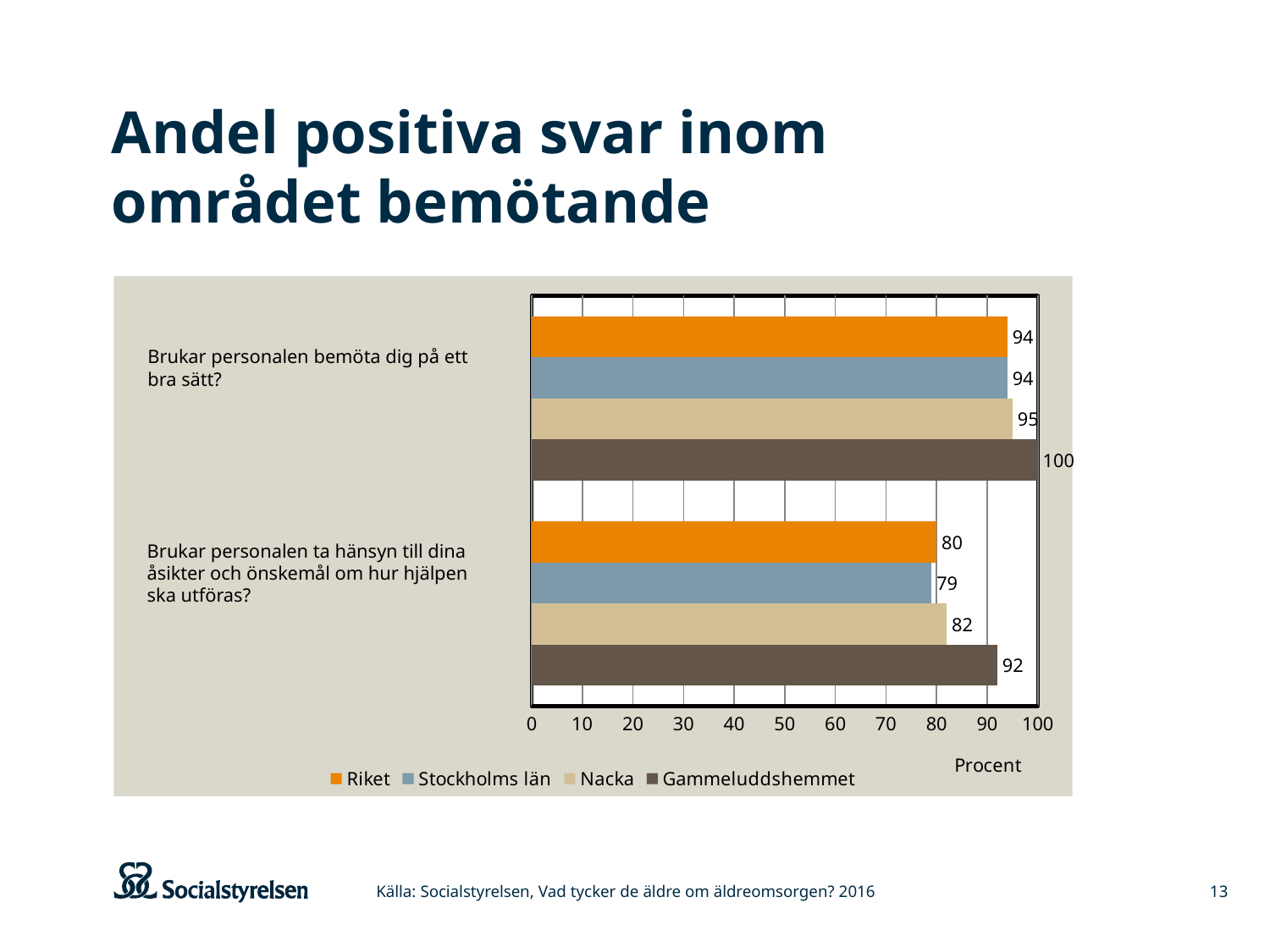
What is the value for Stockholms län on the question "Brukar personalen ta hänsyn till dina åsikter och önskemål om hur hjälpen ska utföras?"? 79 What is the value for Nacka on the question "Brukar personalen bemöta dig på ett bra sätt?"? 95 What is the value for Gammeluddshemmet on the question "Brukar personalen bemöta dig på ett bra sätt?"? 100 Which is larger for Nacka: the value for "Brukar personalen bemöta dig på ett bra sätt?" or for "Brukar personalen ta hänsyn till dina åsikter och önskemål om hur hjälpen ska utföras?"? Brukar personalen bemöta dig på ett bra sätt? What kind of chart is shown on the slide? Bar chart Is the value for Riket on the question "Brukar personalen ta hänsyn till dina åsikter och önskemål om hur hjälpen ska utföras?" greater or less than 90? less What is the difference between Gammeluddshemmet and Riket on the question "Brukar personalen ta hänsyn till dina åsikter och önskemål om hur hjälpen ska utföras?"? 12 What is the label of the horizontal axis? Procent How many series does the legend list? 4 Which series has the highest value on the question "Brukar personalen ta hänsyn till dina åsikter och önskemål om hur hjälpen ska utföras?"? Gammeluddshemmet Which series has the lowest value on the question "Brukar personalen ta hänsyn till dina åsikter och önskemål om hur hjälpen ska utföras?"? Stockholms län How many questions (categories) are shown on the chart? 2